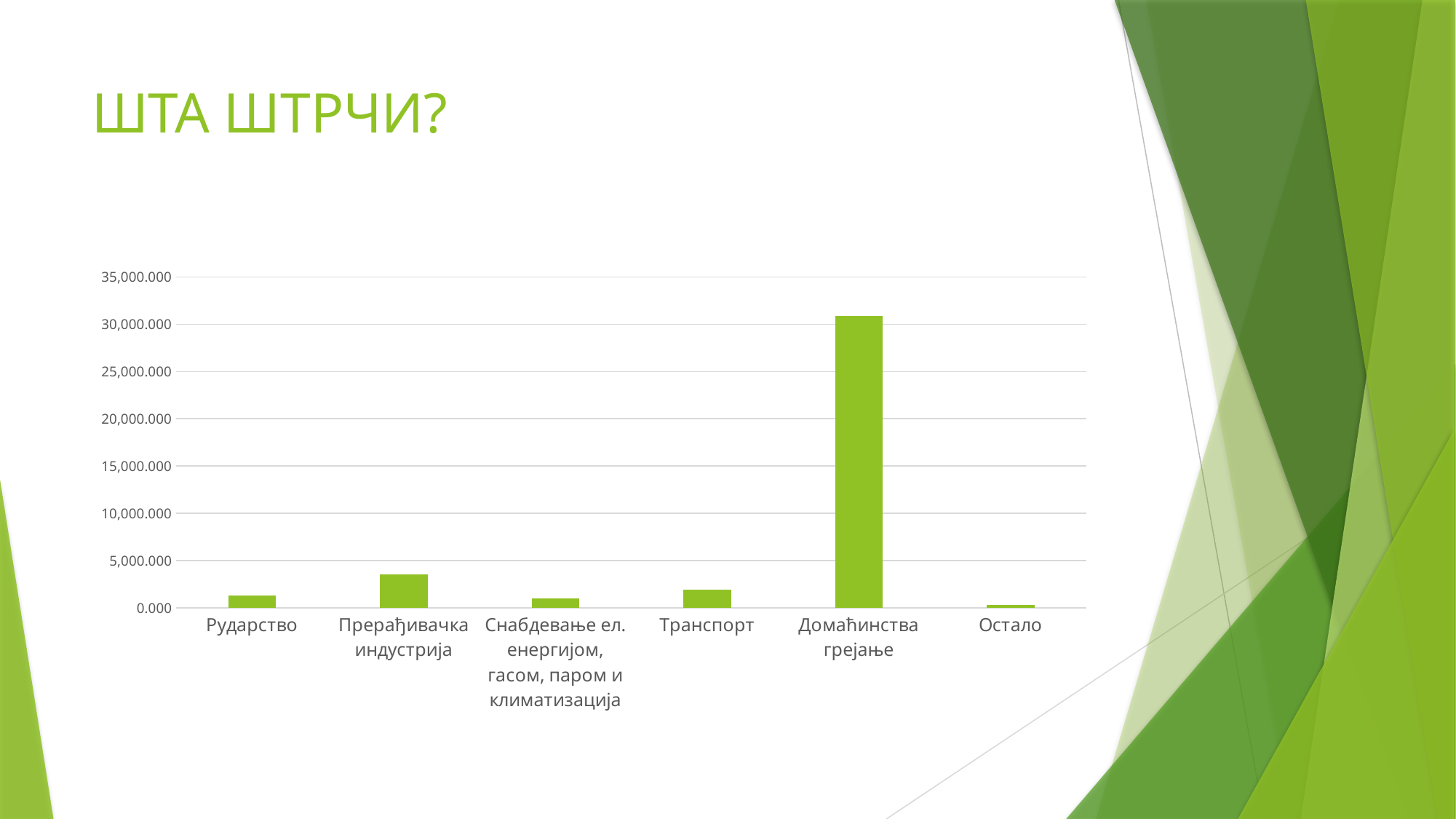
What is the title of the slide containing the chart? ШТА ШТРЧИ? What kind of chart is shown on the slide? bar chart What is the highest value shown on the y axis of the chart? 35,000.000 Is the value for Домаћинства грејање greater or less than 35,000.000? less How many categories are shown on the x axis of the chart? 6 Which is larger, the value for Транспорт or the value for Остало? Транспорт Is the value for Транспорт greater or less than 5,000.000? less Is the value for Прерађивачка индустрија greater or less than 5,000.000? less Which category has the lowest value in the chart? Остало Which is larger, the value for Прерађивачка индустрија or the value for Рударство? Прерађивачка индустрија Which category has the highest value in the chart? Домаћинства грејање